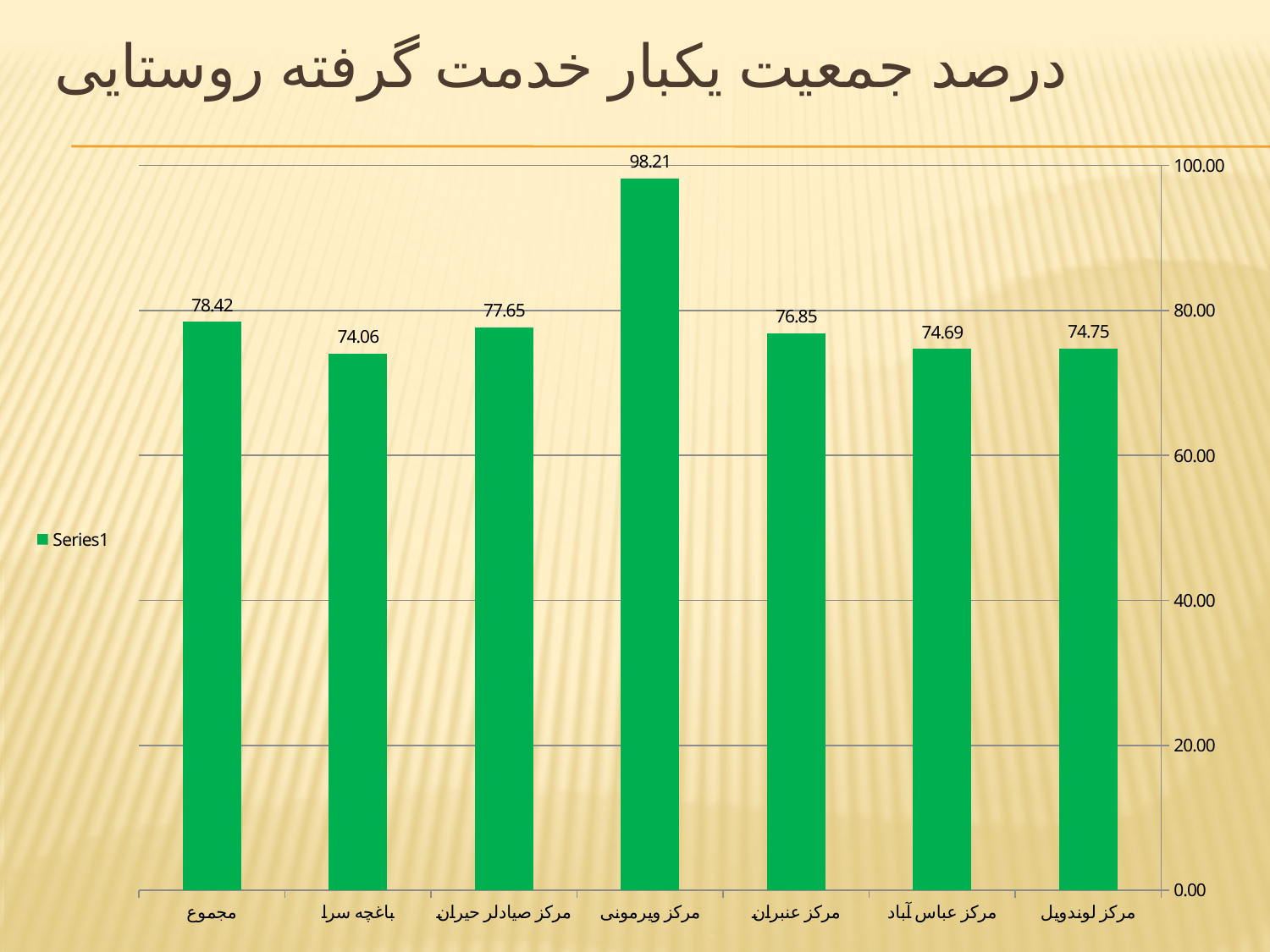
Which is larger, the value for مرکز صیادلر حیران or the value for مرکز لوندویل? مرکز صیادلر حیران What is the value for مرکز عباس آباد? 74.69 What is the value for مجموع? 78.42 How many series does the legend list? 1 What is the difference between the values for مرکز ویرمونی and مرکز عنبران? 21.36 How many categories are shown on the x axis? 7 Is the value for مرکز عنبران greater or less than 80.00? less What is the value for مرکز ویرمونی? 98.21 Which category has the lowest value? باغچه سرا What kind of chart is shown on the slide? bar chart What is the value for باغچه سرا? 74.06 Which category has the highest value? مرکز ویرمونی